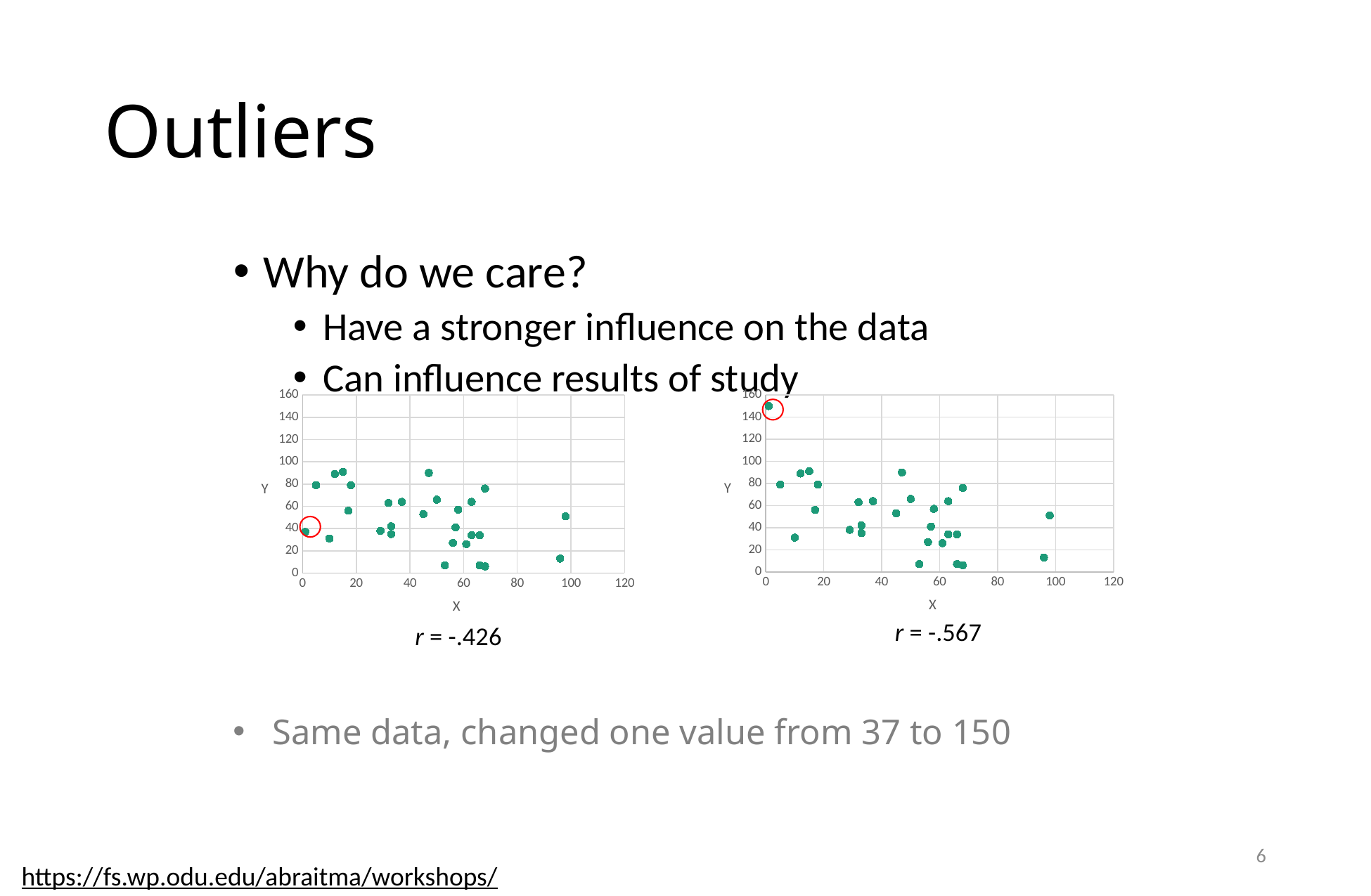
What is the maximum value shown on the Y axis of the left chart? 160 What kind of chart is the left chart? scatter plot In the right chart, is the value of the circled point greater or less than 140? greater What kind of chart is the right chart? scatter plot What is the correlation coefficient r shown under the left chart? r = -.426 In the right chart, is the circled point the highest point on the chart? yes In the left chart, is the Y value of the lowest point near X = 96 greater or less than 20? less What is the correlation coefficient r shown under the right chart? r = -.567